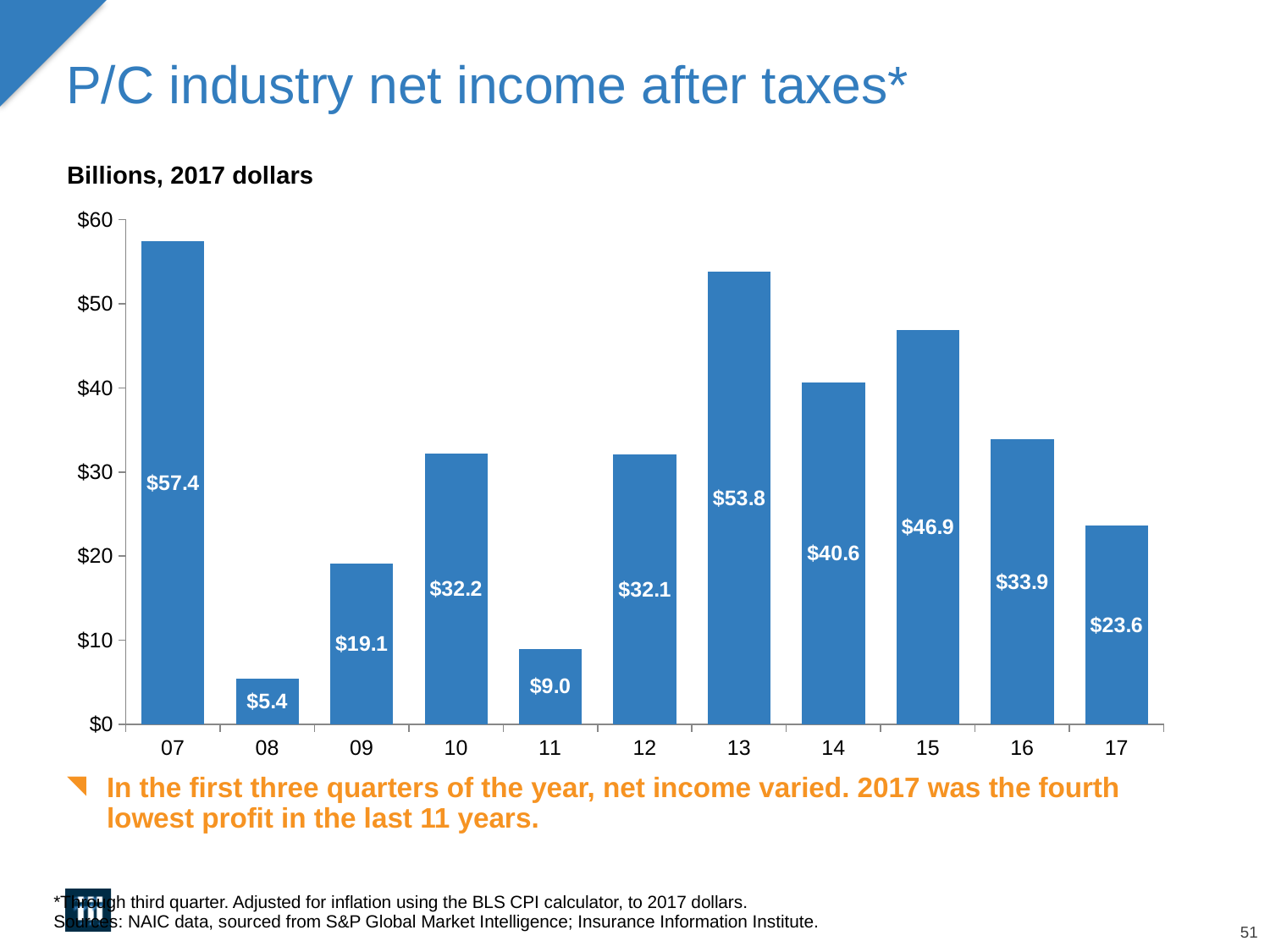
What is the difference between the values for 2015 and 2016? $13.0 Is the value for 2011 greater or less than $10? less Do the values rise or fall from 2015 to 2017? fall What is the net income after taxes for 2013? $53.8 Which year has the lowest net income after taxes? 08 What kind of chart is shown on the slide? bar chart Which year has the highest net income after taxes? 07 How many years are shown on the x axis? 11 What is the value shown for 2017? $23.6 What is the value shown for 2008? $5.4 Which year has the larger value, 2014 or 2016? 14 What is the difference between the values for 2007 and 2008? $52.0